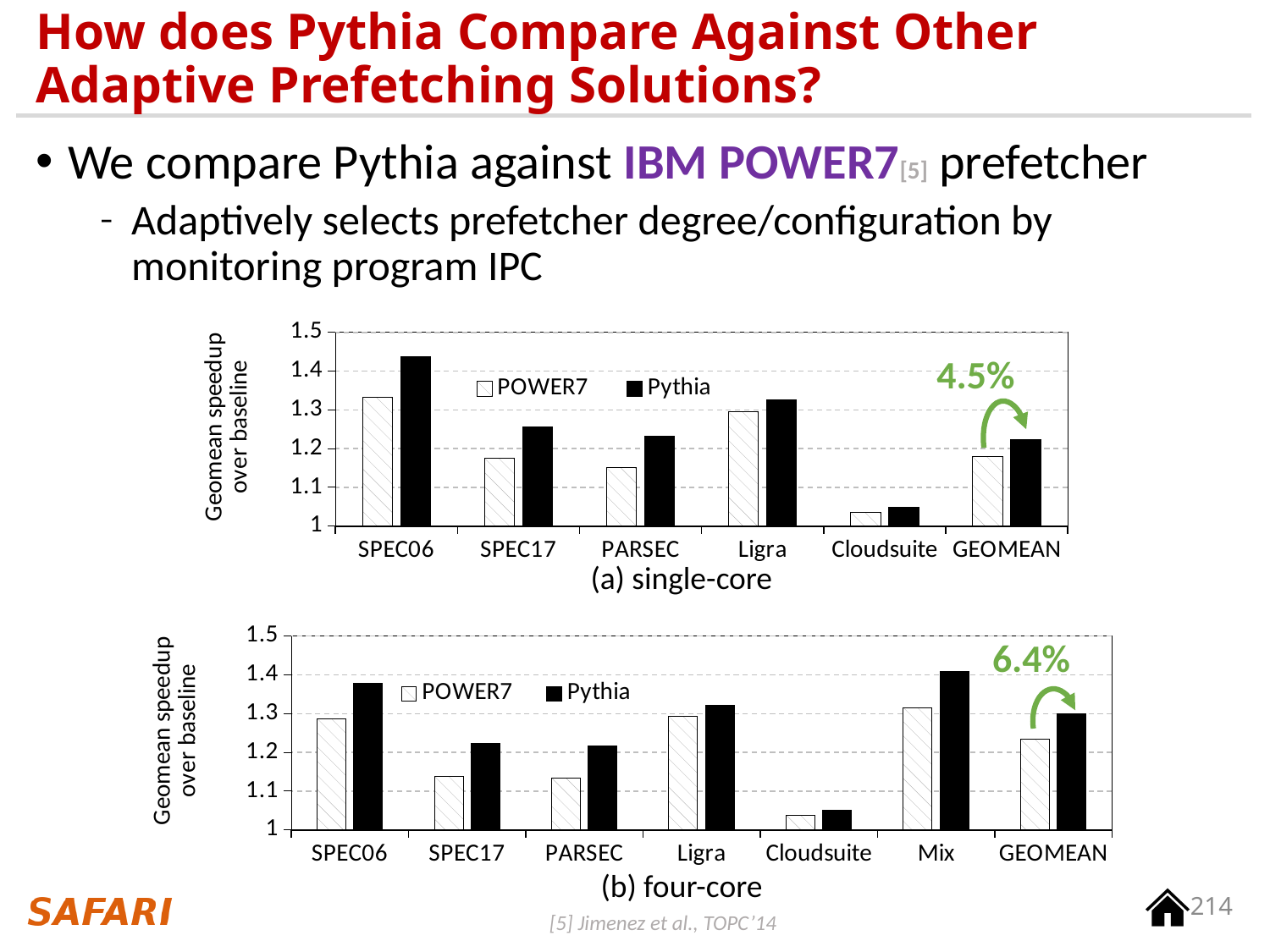
How many series does the legend of the (b) four-core chart list? 2 In the (b) four-core chart, is the POWER7 value for SPEC17 greater or less than 1.2? less What percentage improvement is annotated above the GEOMEAN bars in the (b) four-core chart? 6.4% In the (a) single-core chart, which category has the highest Pythia bar? SPEC06 In the (a) single-core chart, is the Pythia value for SPEC06 greater or less than 1.4? greater How many workload categories are shown on the x axis of the (a) single-core chart? 6 How many workload categories are shown on the x axis of the (b) four-core chart? 7 What percentage improvement is annotated above the GEOMEAN bars in the (a) single-core chart? 4.5% What kind of chart is the (a) single-core chart? bar chart In the (b) four-core chart, which category has the lowest POWER7 bar? Cloudsuite In the (a) single-core chart, which is larger for PARSEC: the POWER7 bar or the Pythia bar? Pythia